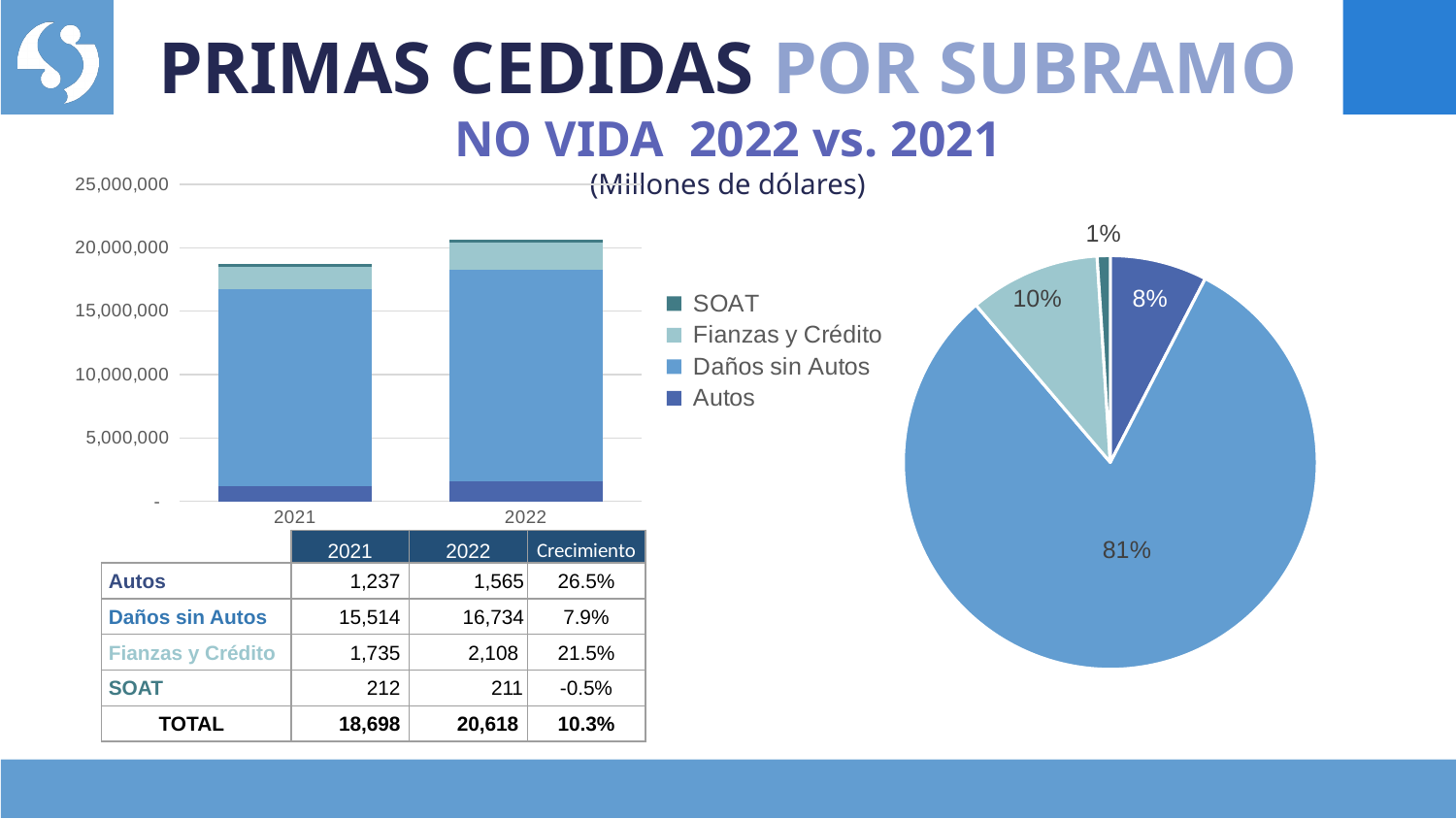
In the bar chart on the left, does the total stacked bar rise or fall from 2021 to 2022? rise In the pie chart on the right, which slice is larger, Fianzas y Crédito or Autos? Fianzas y Crédito In the pie chart on the right, which category has the smallest slice? SOAT In the pie chart on the right, what is the difference in percentage points between the Daños sin Autos slice and the Fianzas y Crédito slice? 71% In the bar chart on the left, is the total height of the 2022 stacked bar greater or less than 20,000,000? greater In the bar chart on the left, is the total height of the 2021 stacked bar greater or less than 20,000,000? less What kind of chart is the chart on the left of the slide? bar chart In the pie chart on the right, what share does Autos have? 8% How many series does the legend list? 4 How many categories are shown on the x axis of the bar chart on the left? 2 In the pie chart on the right, what share does Fianzas y Crédito have? 10% In the pie chart on the right, what share does Daños sin Autos have? 81%